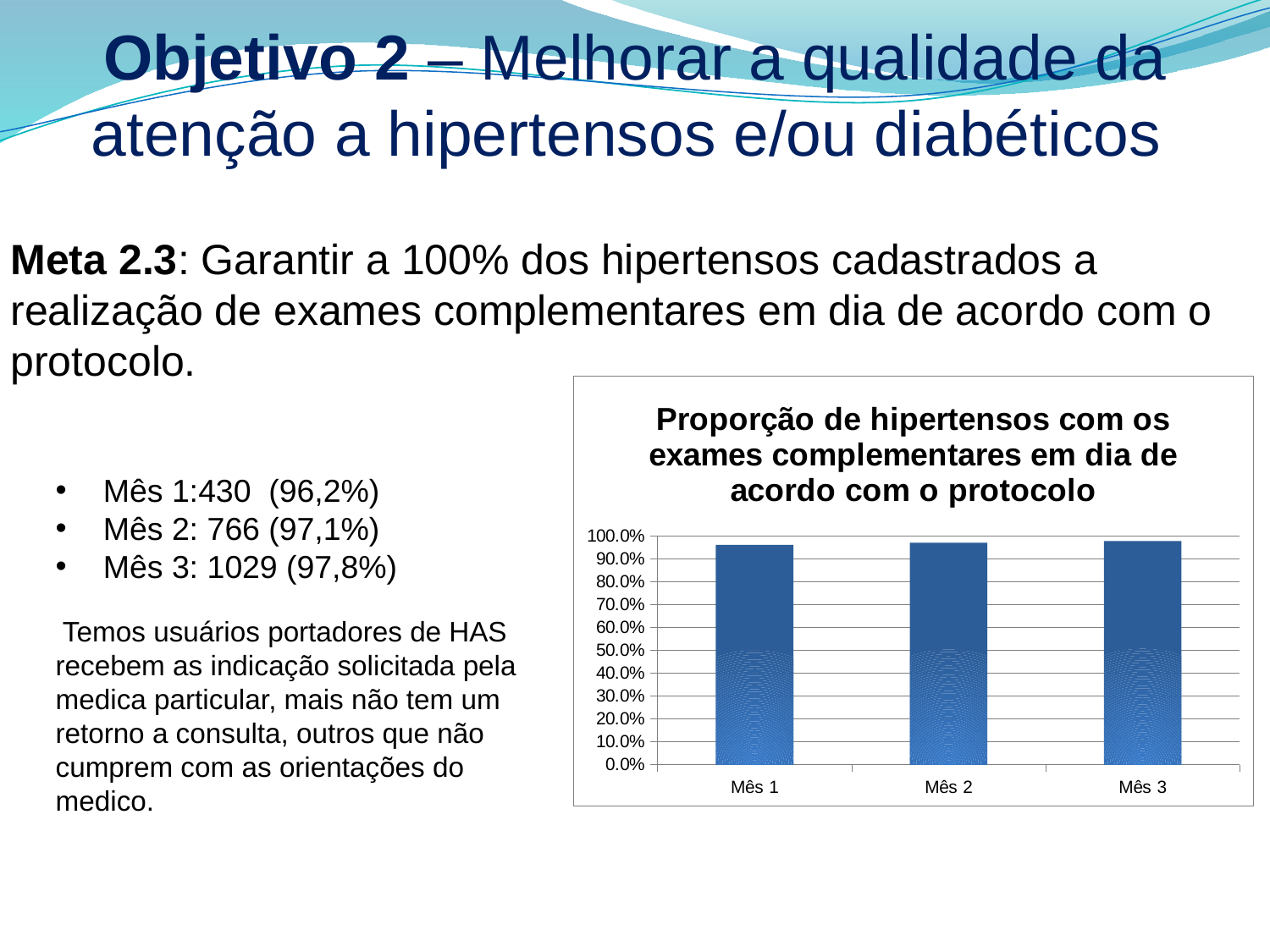
Is the value for Mês 2 greater or less than 50.0%? greater What is the highest value shown on the chart's vertical axis? 100.0% Is the value for Mês 1 greater or less than 90.0%? greater Is the value for Mês 2 greater or less than 90.0%? greater What kind of chart is shown on the slide? bar chart What is the title of the chart? Proporção de hipertensos com os exames complementares em dia de acordo com o protocolo How many categories (months) are plotted in the chart? 3